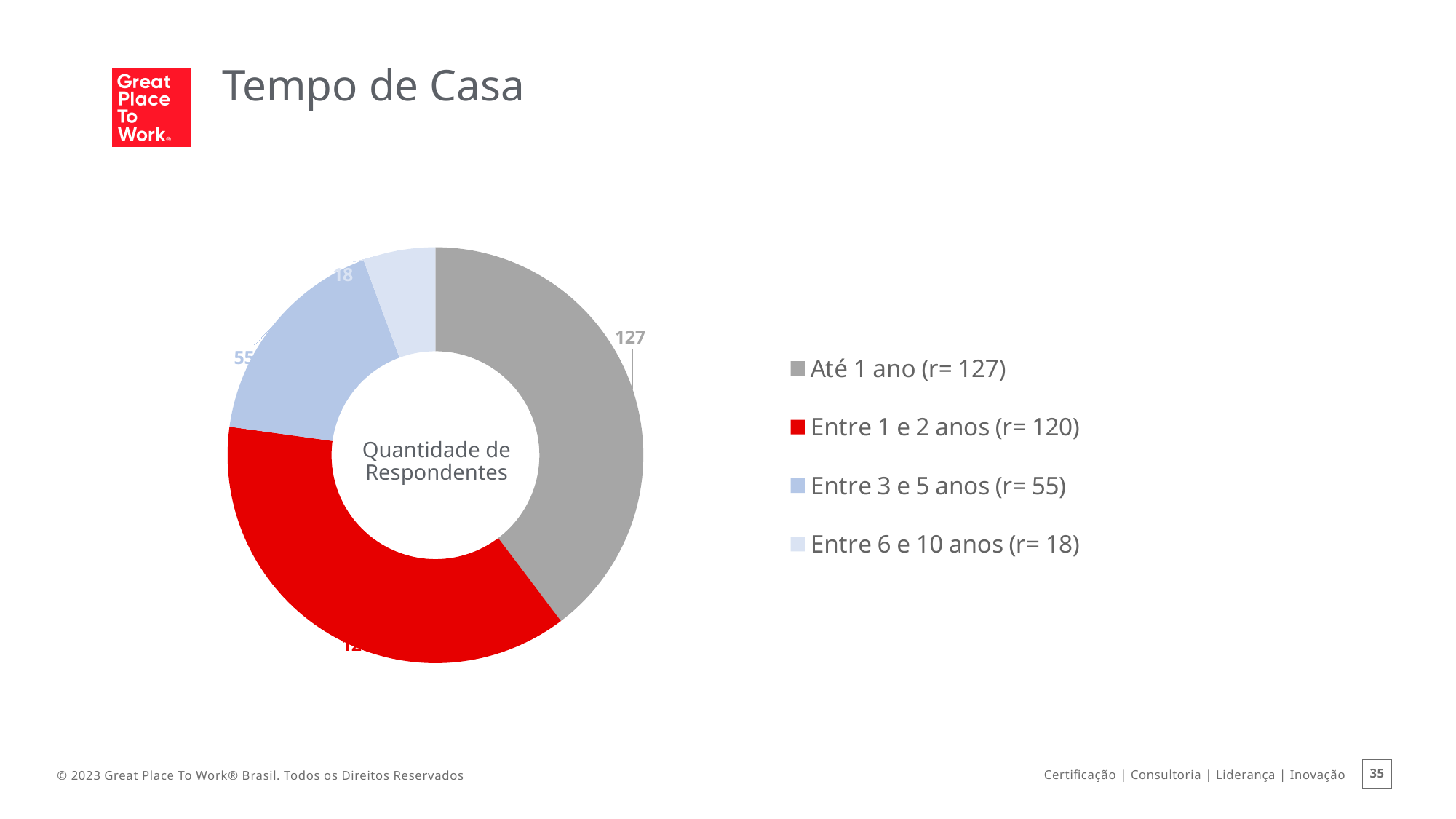
What kind of chart is shown on the slide? Donut (pie) chart Which category has the lowest number of respondents? Entre 6 e 10 anos How many respondents are in the 'Até 1 ano' category? 127 How many respondents are in the 'Entre 1 e 2 anos' category? 120 Which category has the highest number of respondents? Até 1 ano How many respondents are in the 'Entre 6 e 10 anos' category? 18 How many categories does the chart show? 4 What is the difference in respondents between 'Até 1 ano' and 'Entre 1 e 2 anos'? 7 How many respondents are in the 'Entre 3 e 5 anos' category? 55 What is the difference in respondents between 'Entre 3 e 5 anos' and 'Entre 6 e 10 anos'? 37 What is the title of the slide containing the chart? Tempo de Casa Which has more respondents: 'Entre 3 e 5 anos' or 'Entre 6 e 10 anos'? Entre 3 e 5 anos